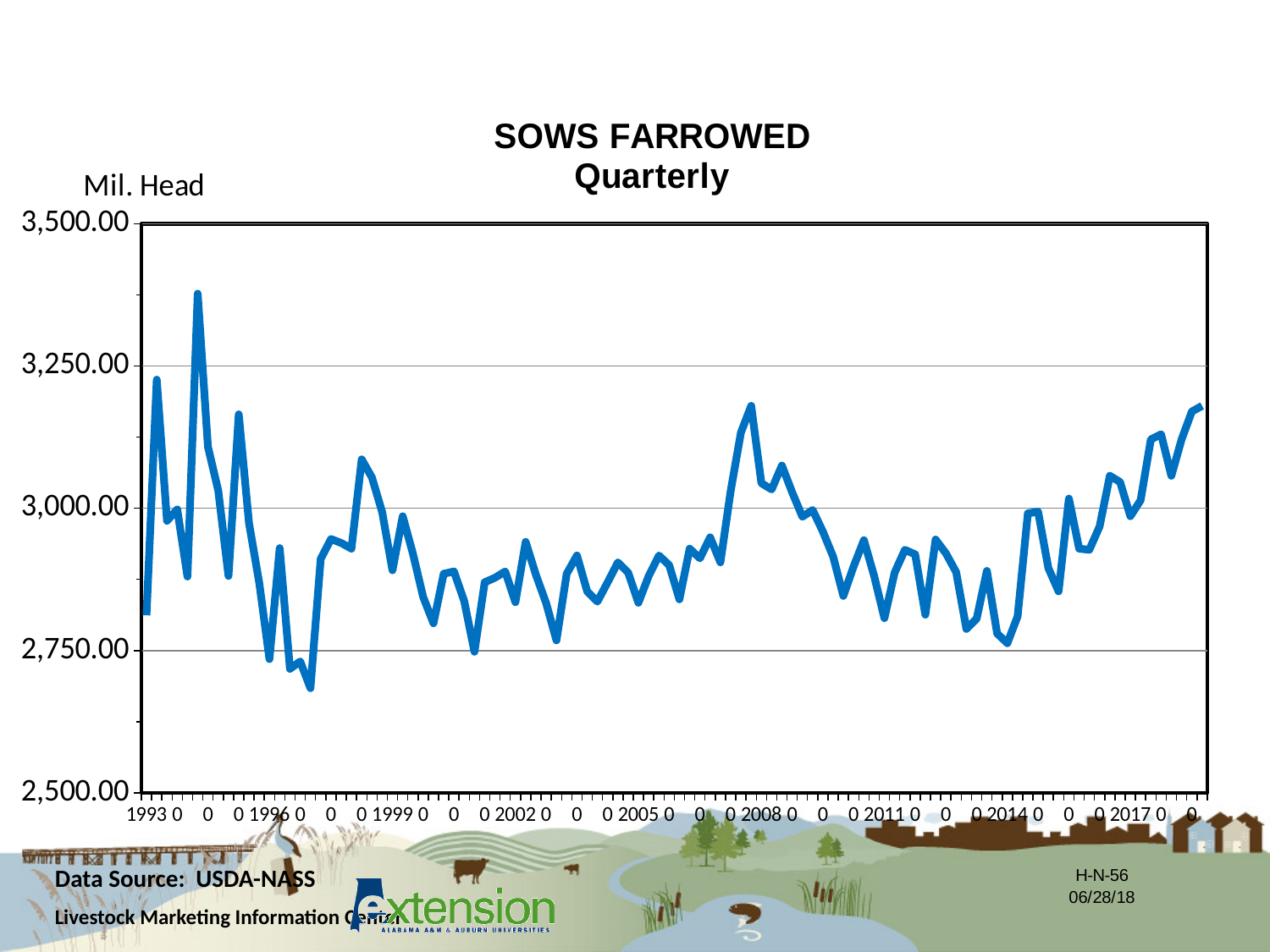
Is the value at the end of the series, after 2017, greater or less than 3,000.00? greater In which year does the line reach its highest peak? 1994 Is the value at 2002 greater or less than 3,000.00? less Do the values generally rise or fall from 2014 to the end of 2017? rise Is the value at 2011 greater or less than 3,000.00? less Which is larger, the peak value around 1995 or the peak value around 2008? the peak around 1995 What unit label is shown on the vertical axis of the chart? Mil. Head What kind of chart is shown on the slide? line chart What is the title of the chart? SOWS FARROWED Quarterly